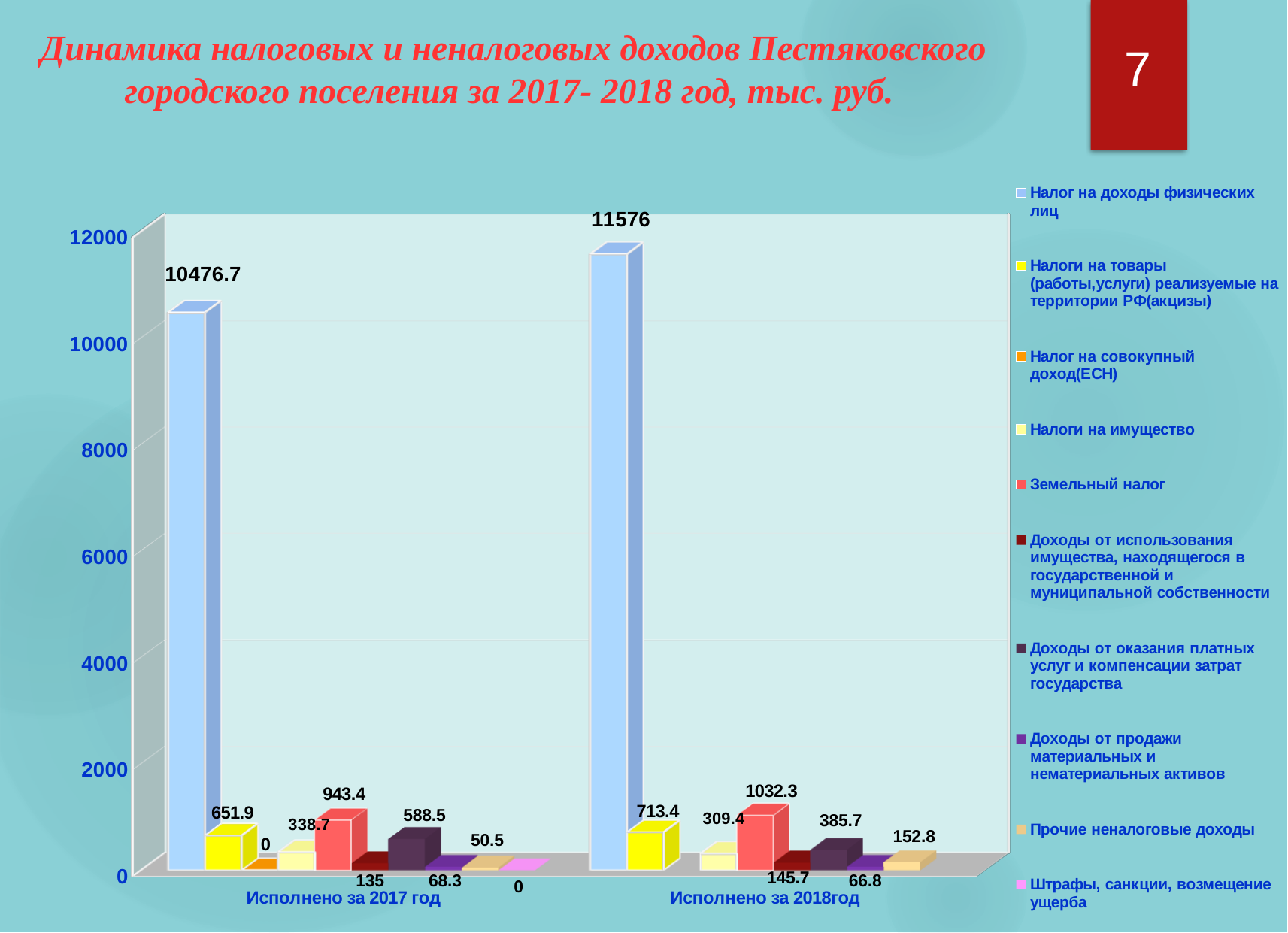
Which year has the larger value for Земельный налог, 2017 or 2018? 2018 How many series does the legend list? 10 By how much did Налог на доходы физических лиц increase from 2017 to 2018? 1099.3 What is the value for Налоги на товары (работы,услуги) реализуемые на территории РФ(акцизы) in Исполнено за 2017 год? 651.9 What is the difference between the Земельный налог values for 2018 and 2017? 88.9 What is the value for Прочие неналоговые доходы in Исполнено за 2018год? 152.8 What is the value for Налог на доходы физических лиц in Исполнено за 2017 год? 10476.7 What is the value for Налог на доходы физических лиц in Исполнено за 2018год? 11576 Which series has the highest value in Исполнено за 2018год? Налог на доходы физических лиц What is the value for Земельный налог in Исполнено за 2018год? 1032.3 What is the value for Доходы от оказания платных услуг и компенсации затрат государства in Исполнено за 2017 год? 588.5 What kind of chart is shown on the slide? Bar chart